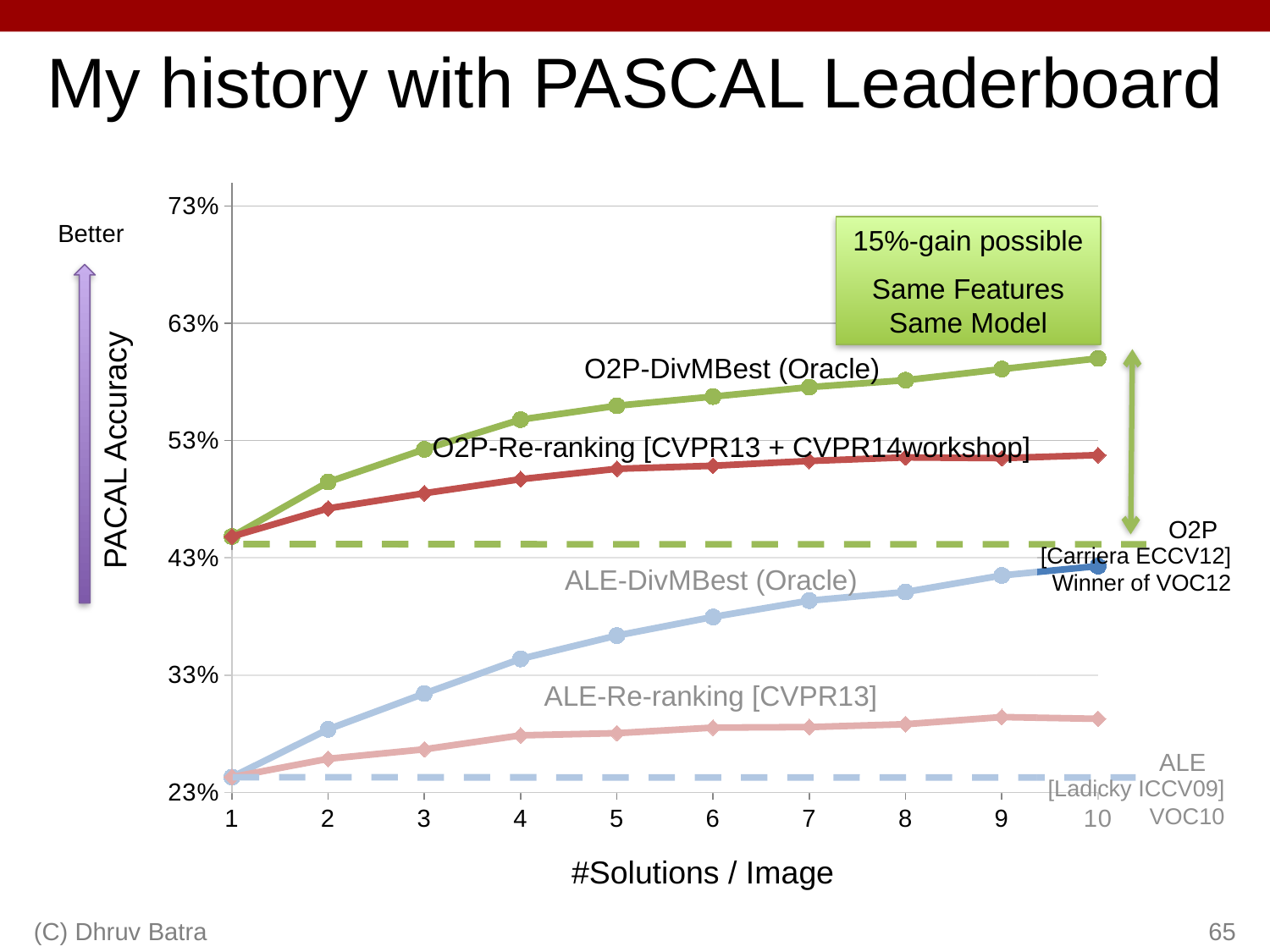
Is the value for ALE-DivMBest (Oracle) at 10 solutions per image greater or less than 33%? greater What is the label of the x axis? #Solutions / Image Which series has the lowest value at 10 solutions per image? ALE-Re-ranking [CVPR13] What is the label of the y axis? PACAL Accuracy Is the value for O2P-DivMBest (Oracle) at 10 solutions per image greater or less than 63%? less Does the O2P-DivMBest (Oracle) line rise or fall as #Solutions / Image increases from 1 to 10? rise Is the value for O2P-DivMBest (Oracle) at 10 solutions per image greater or less than 53%? greater At 10 solutions per image, which is larger: O2P-DivMBest (Oracle) or ALE-DivMBest (Oracle)? O2P-DivMBest (Oracle) Which series has the highest value at 10 solutions per image? O2P-DivMBest (Oracle) How many values of #Solutions / Image are shown on the x axis? 10 What kind of chart is shown on the slide? line chart